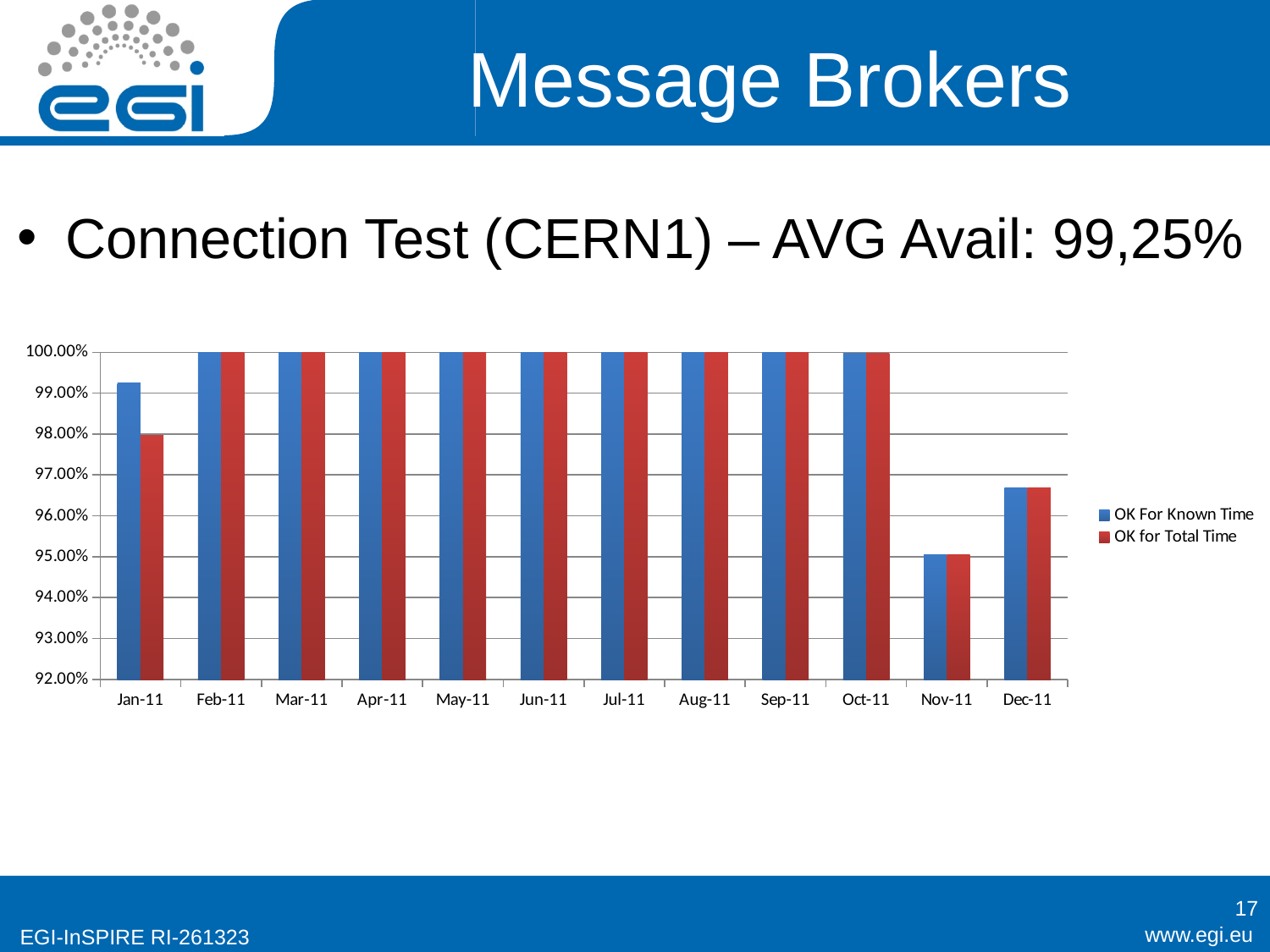
What kind of chart is shown on the slide? bar chart What is the value of OK For Known Time for Feb-11? 100.00% How many series does the chart legend list? 2 For Jan-11, which series has the larger value: OK For Known Time or OK for Total Time? OK For Known Time Which month has the lowest value for OK For Known Time? Nov-11 What is the value of OK for Total Time for Jul-11? 100.00% What are the two series named in the chart legend? OK For Known Time and OK for Total Time Is the value of OK For Known Time for Nov-11 greater or less than 96.00%? less Is the value of OK for Total Time for Dec-11 greater or less than 96.00%? greater How many months are shown on the x axis of the chart? 12 Is the value of OK For Known Time for Jan-11 greater or less than 99.00%? greater Which is larger: OK for Total Time for Nov-11 or OK for Total Time for Dec-11? Dec-11